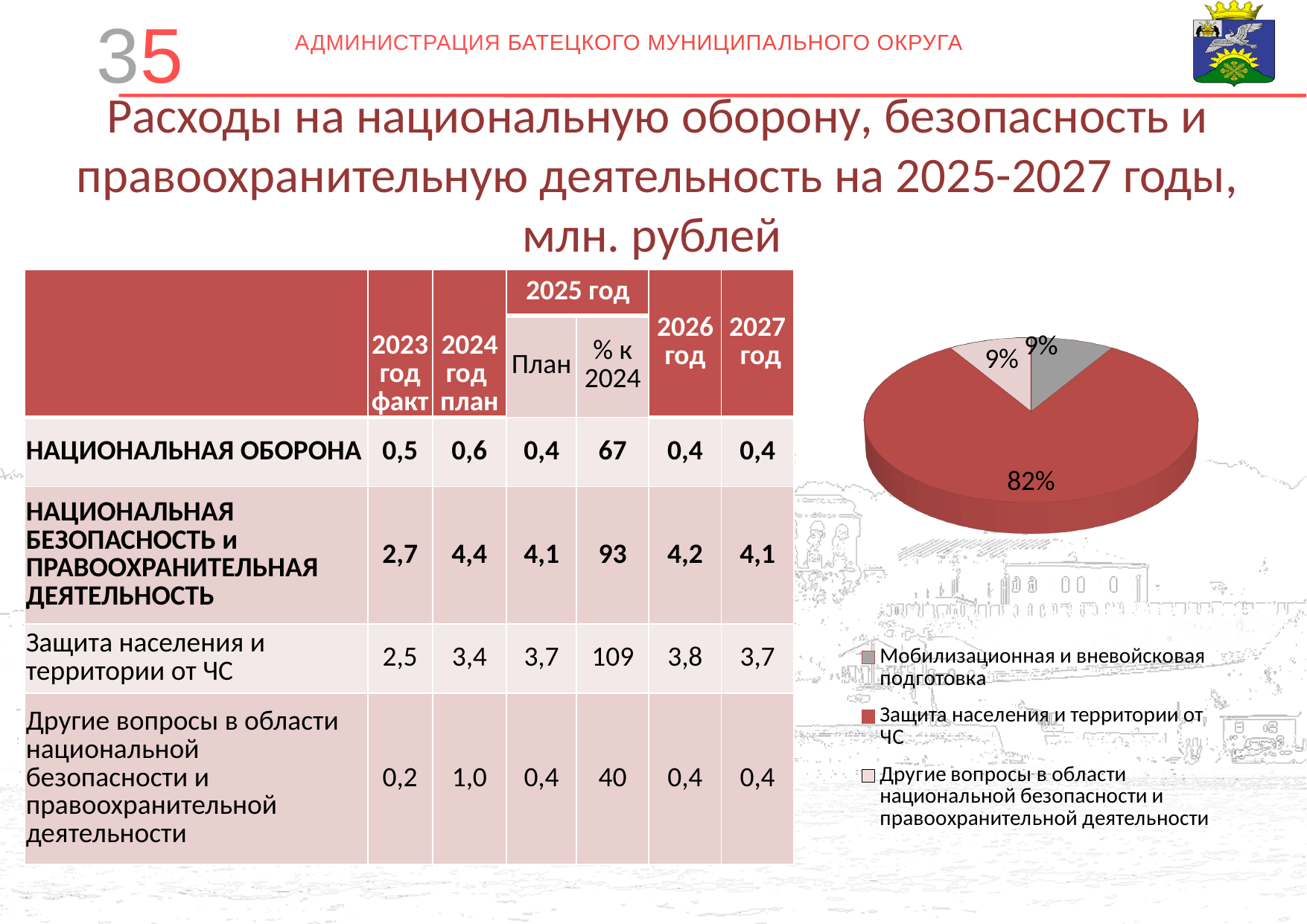
How many entries does the pie chart legend list? 3 What colour is the largest slice of the pie chart? dark red In the pie chart, what share is shown for "Мобилизационная и вневойсковая подготовка"? 9% In the pie chart, what share is shown for "Защита населения и территории от ЧС"? 82% In the pie chart, which is larger: the slice for "Защита населения и территории от ЧС" or the slice for "Мобилизационная и вневойсковая подготовка"? Защита населения и территории от ЧС In the pie chart, is the share for "Защита населения и территории от ЧС" greater or less than 50%? greater Which category has the largest slice in the pie chart? Защита населения и территории от ЧС In the pie chart, what share is shown for "Другие вопросы в области национальной безопасности и правоохранительной деятельности"? 9% How many slices does the pie chart have? 3 In the pie chart, what is the difference in percentage points between the slice for "Защита населения и территории от ЧС" and the slice for "Другие вопросы в области национальной безопасности и правоохранительной деятельности"? 73% What type of chart is shown on the right side of the slide? pie chart Which legend entry of the pie chart is marked in grey? Мобилизационная и вневойсковая подготовка